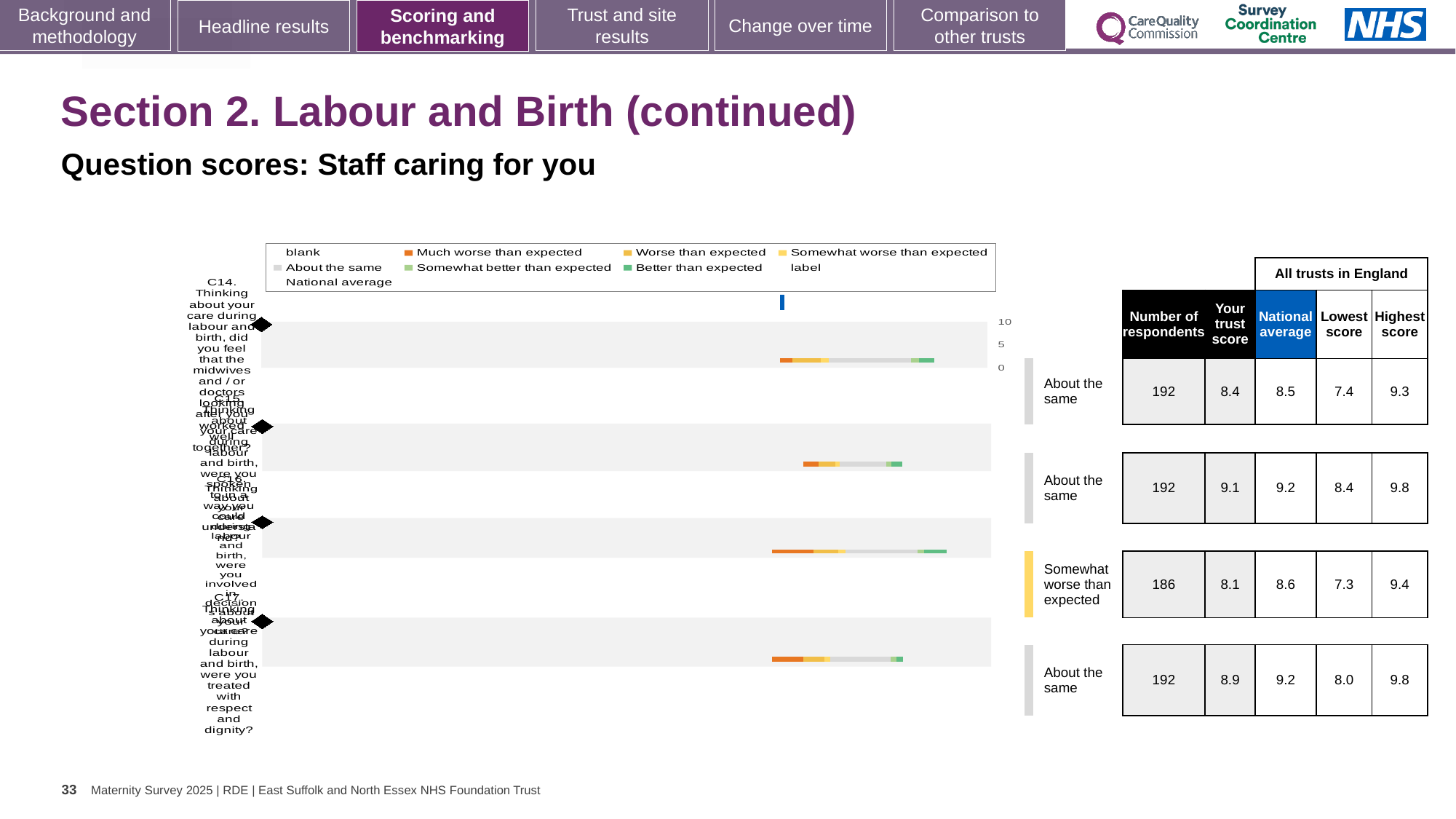
How many question rows (diamond markers) are plotted on the chart? 4 In the table beside the chart, is the trust score for the second row (9.1) larger or smaller than its national average (9.2)? smaller In the table beside the chart, which row has the highest trust score? the second row (9.1) In the table beside the chart, what is the trust score for the row rated 'Somewhat worse than expected'? 8.1 In the table beside the chart, what is the number of respondents for the row rated 'Somewhat worse than expected'? 186 What kind of chart is shown on the slide? bar chart In the table beside the chart, how many of the four rows are rated 'About the same'? 3 How many entries does the chart legend list? 9 In the table beside the chart, what is the national average for the row rated 'Somewhat worse than expected'? 8.6 In the table beside the chart, what is the difference between the national average and the trust score for the row rated 'Somewhat worse than expected'? 0.5 What is the highest tick value shown on the chart's score axis? 10 What colour represents 'Much worse than expected' in the chart legend? orange